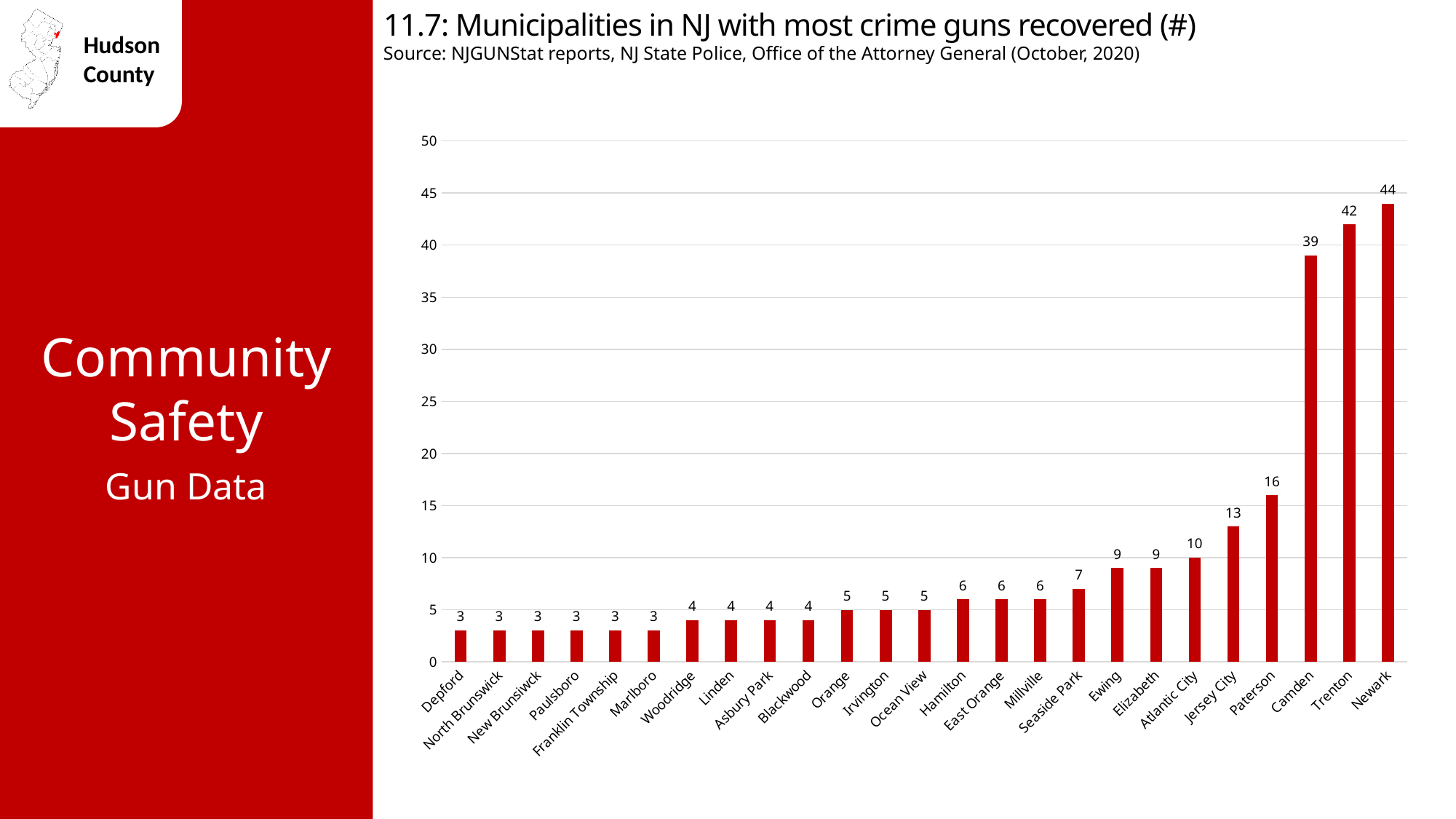
How many municipalities are shown on the chart? 25 Which has a larger value, Ewing or Seaside Park? Ewing How many crime guns were recovered in Jersey City? 13 Which municipality has the highest number of crime guns recovered? Newark What is the difference between the values for Newark and Trenton? 2 What is the value shown for Camden? 39 Do the values rise or fall moving from left to right along the x axis? Rise What is the difference between the values for Paterson and Jersey City? 3 What is the value shown for Atlantic City? 10 What kind of chart is shown on the slide? Bar chart Is the value for Trenton greater or less than 40? greater Which has a larger value, Camden or Paterson? Camden